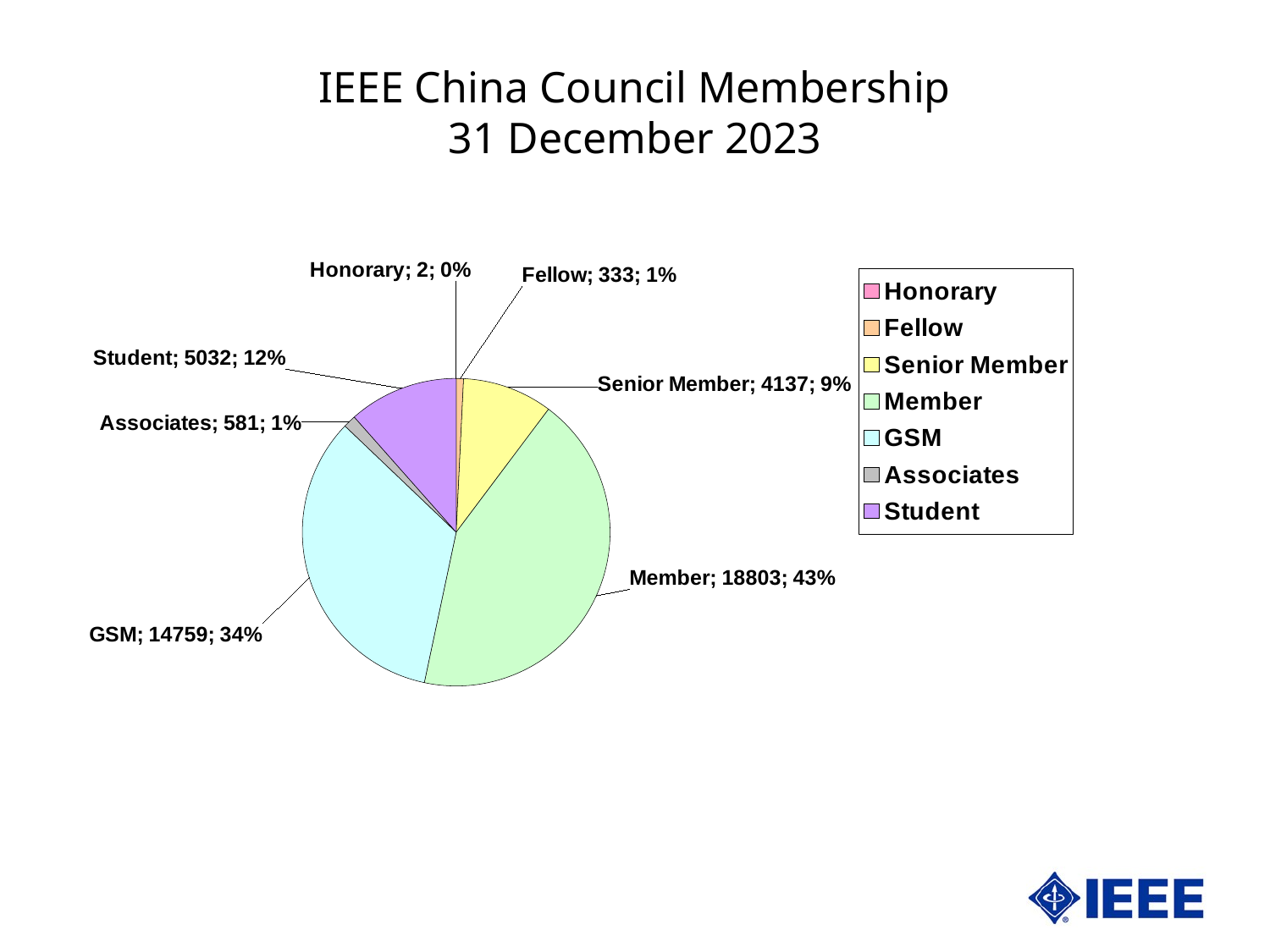
How many entries does the legend list? 7 What kind of chart is shown on the slide? pie chart What is the title of the chart? IEEE China Council Membership 31 December 2023 What is the value for GSM? 14759 What share of the pie does Senior Member represent? 9% Which is larger, Associates or Fellow? Associates Which category has the smallest slice? Honorary What is the difference between the Member and GSM values? 4044 Which category has the largest slice? Member How many members are in the Member category? 18803 How many categories does the pie chart have? 7 What share of the pie does Student represent? 12%